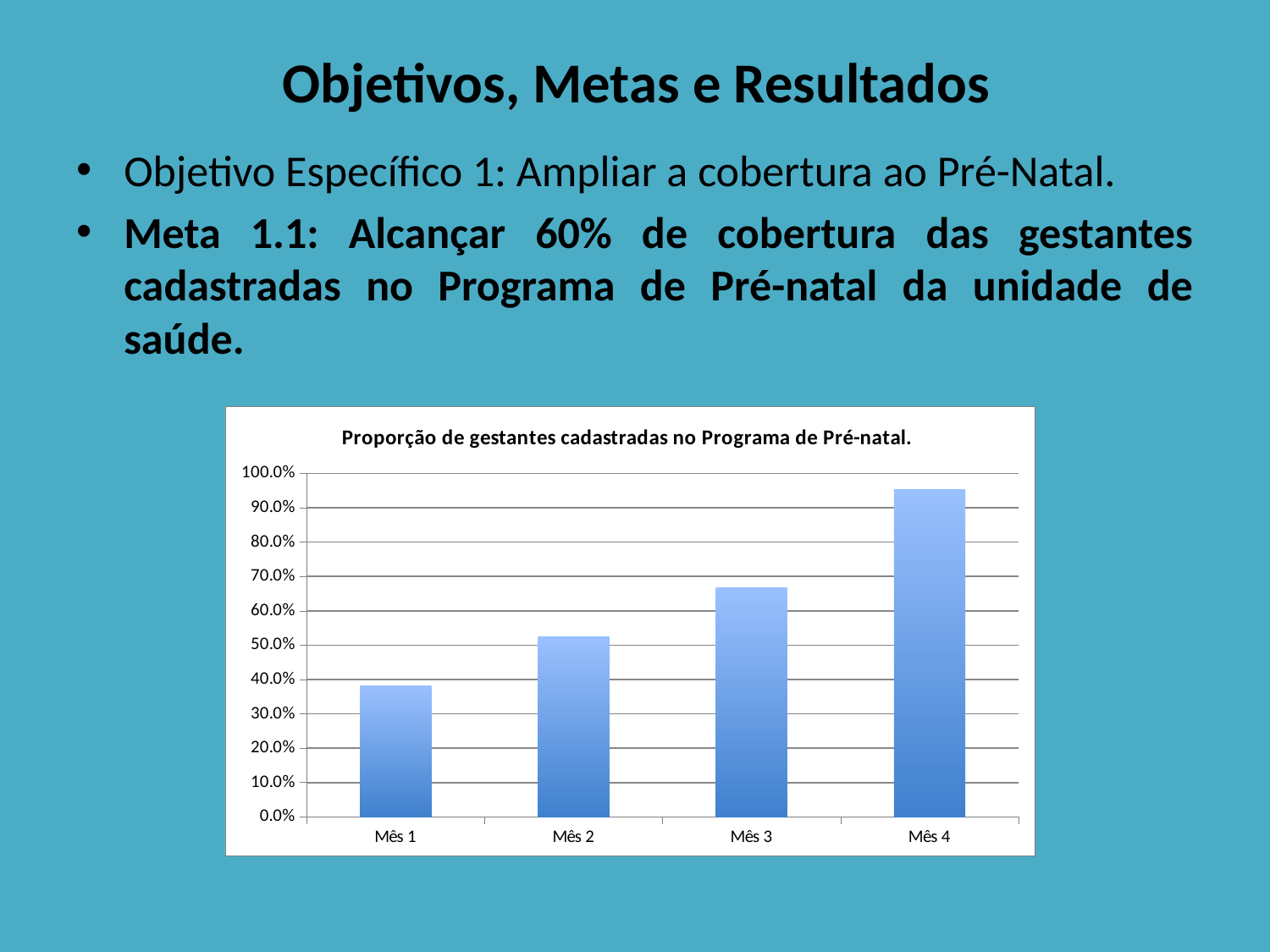
Which month has the lowest value in the chart? Mês 1 Is the value for Mês 1 greater or less than 40.0%? less Is the value for Mês 3 greater or less than 60.0%? greater Is the value for Mês 2 greater or less than 50.0%? greater What is the title of the chart? Proporção de gestantes cadastradas no Programa de Pré-natal. What is the highest value shown on the vertical axis of the chart? 100.0% Which month has the highest value in the chart? Mês 4 How many categories (months) are plotted in the chart? 4 What kind of chart is shown on the slide? bar chart Which is larger, the value for Mês 2 or the value for Mês 3? Mês 3 Do the values rise or fall from Mês 1 to Mês 4? rise